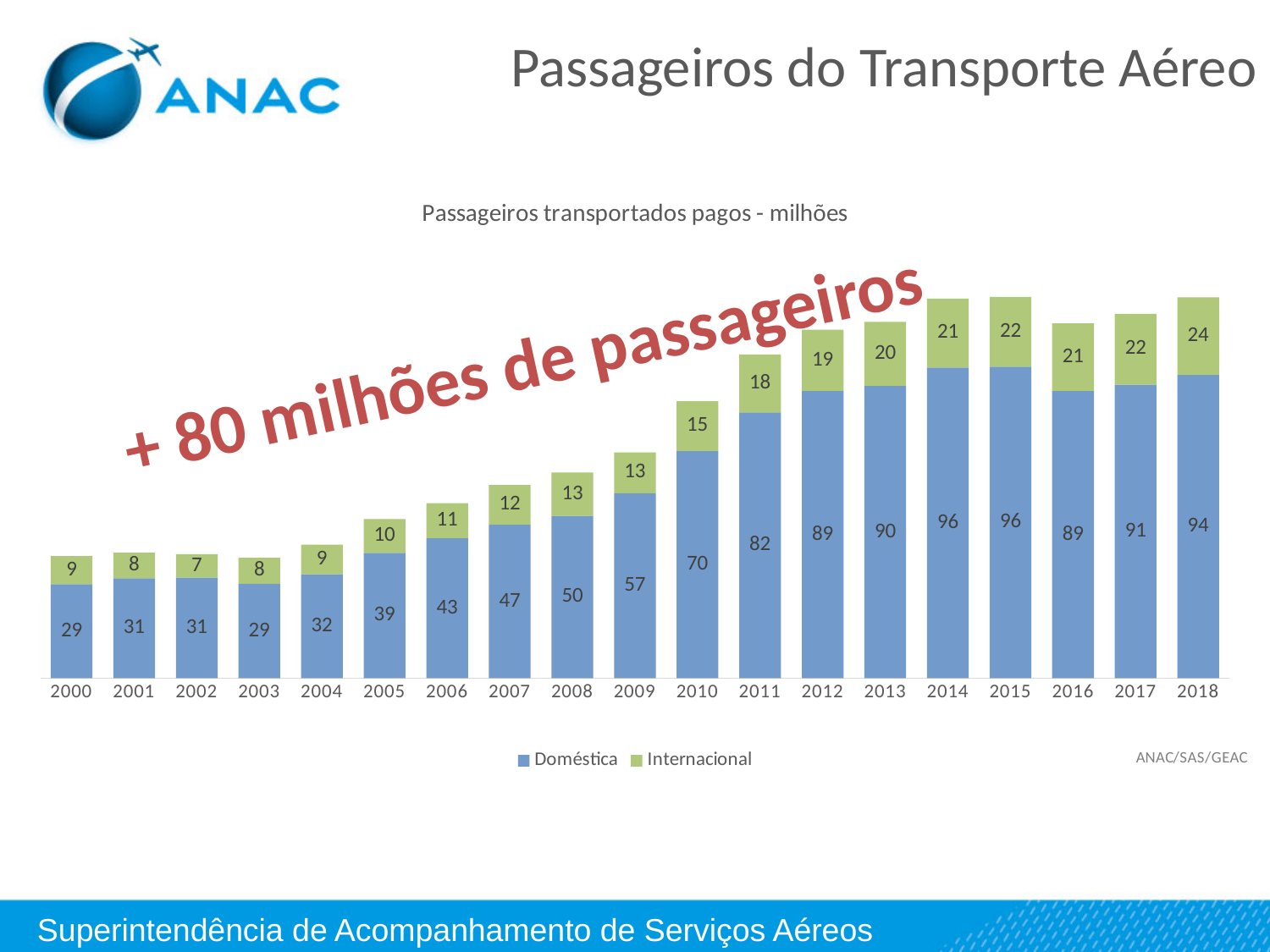
What is the Internacional value for 2018? 24 What is the total of the stacked bar for 2018? 118 What is the Doméstica value for 2010? 70 What is the Doméstica value for 2000? 29 How many series does the legend list? 2 What is the total of the stacked bar for 2005? 49 Which is larger, the Doméstica value for 2011 or for 2016? 2016 Which year has the highest Internacional value? 2018 What is the difference between the Doméstica values for 2018 and 2000? 65 How many years are shown on the x axis? 19 Which year has the lowest Internacional value? 2002 What kind of chart is shown on the slide? Stacked bar chart